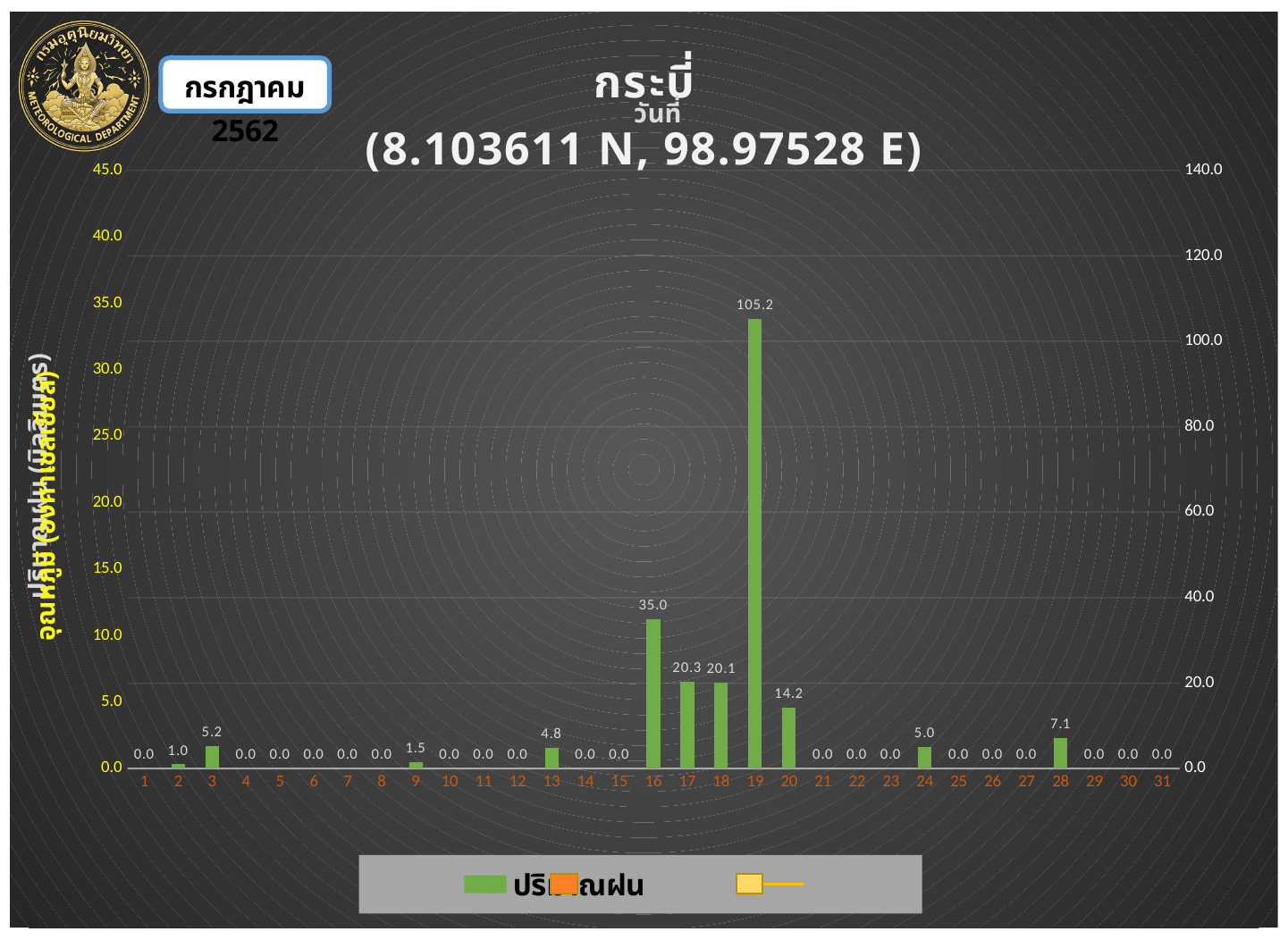
Is the value for day 19 greater or less than 100.0 on the right axis? greater What is the rainfall value shown for day 19? 105.2 What is the difference between the values for day 19 and day 16? 70.2 Which day has the highest bar? 19 What is the highest tick value on the right-hand axis? 140.0 What is the value shown for day 28? 7.1 What is the value shown for day 16? 35.0 Which is larger, the value for day 20 or the value for day 24? day 20 What kind of chart is this? bar chart What is the difference between the values for day 17 and day 18? 0.2 What is the value shown for day 13? 4.8 How many days are shown on the x axis? 31